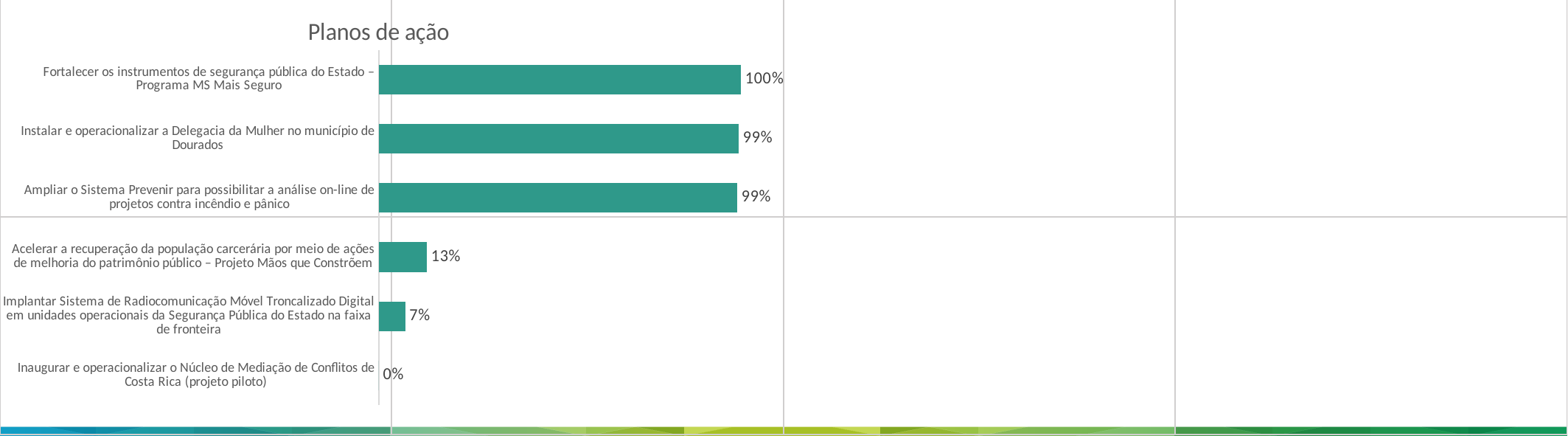
Which is larger: the value for "Ampliar o Sistema Prevenir" or the value for "Acelerar a recuperação da população carcerária"? Ampliar o Sistema Prevenir What is the value for "Inaugurar e operacionalizar o Núcleo de Mediação de Conflitos de Costa Rica (projeto piloto)"? 0% What is the value for "Acelerar a recuperação da população carcerária por meio de ações de melhoria do patrimônio público – Projeto Mãos que Constrõem"? 13% What is the difference between the value for "Acelerar a recuperação da população carcerária" (Projeto Mãos que Constrõem) and the value for "Implantar Sistema de Radiocomunicação Móvel Troncalizado Digital"? 6% Which category has the lowest value? Inaugurar e operacionalizar o Núcleo de Mediação de Conflitos de Costa Rica (projeto piloto) What kind of chart is shown on the slide? Bar chart Which category has the highest value? Fortalecer os instrumentos de segurança pública do Estado – Programa MS Mais Seguro What is the title of the chart? Planos de ação How many categories are shown in the chart? 6 What is the value for "Instalar e operacionalizar a Delegacia da Mulher no município de Dourados"? 99% What is the value for "Implantar Sistema de Radiocomunicação Móvel Troncalizado Digital em unidades operacionais da Segurança Pública do Estado na faixa de fronteira"? 7% What is the value for "Fortalecer os instrumentos de segurança pública do Estado – Programa MS Mais Seguro"? 100%